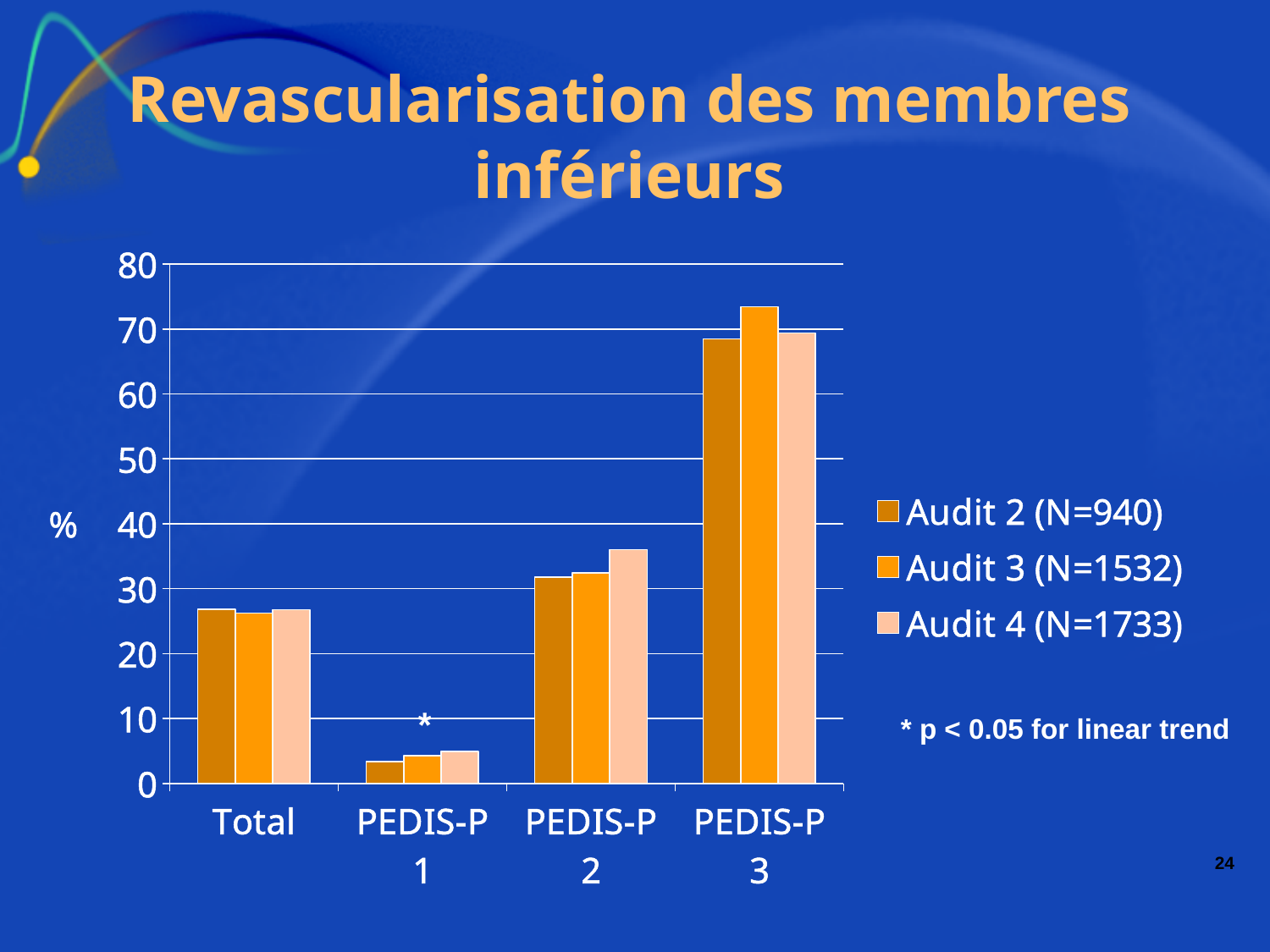
How many categories are shown on the x axis? 4 Which category has the lowest value for Audit 2 (N=940)? PEDIS-P 1 Is the value for Audit 4 (N=1733) in PEDIS-P 2 greater or less than 30? greater What kind of chart is shown on the slide? bar chart Is the value for Audit 2 (N=940) in PEDIS-P 1 greater or less than 10? less Do the values rise or fall going from PEDIS-P 1 to PEDIS-P 3? rise Is the value for Audit 3 (N=1532) in PEDIS-P 3 greater or less than 70? greater How many series does the legend list? 3 What is the sample size (N) given in the legend for Audit 4? 1733 Which category has the highest value for Audit 3 (N=1532)? PEDIS-P 3 In PEDIS-P 2, which is larger: the value for Audit 2 (N=940) or Audit 4 (N=1733)? Audit 4 (N=1733)